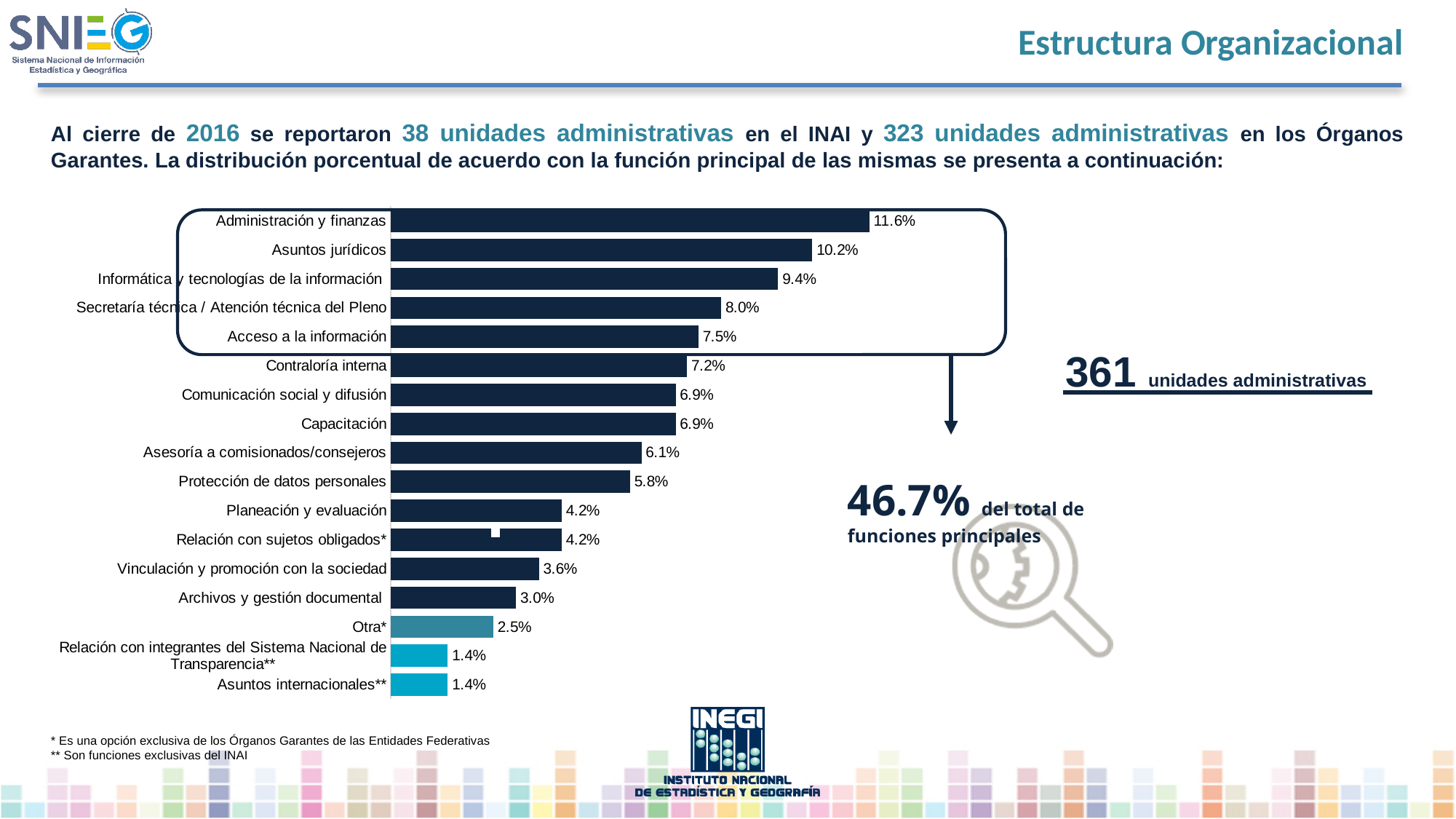
What is the difference between Secretaría técnica / Atención técnica del Pleno and Acceso a la información? 0.5% What is the combined percentage of the five categories enclosed in the rounded box at the top of the chart? 46.7% What percentage is shown for Administración y finanzas? 11.6% Which category has the highest percentage in the chart? Administración y finanzas Which is larger, Vinculación y promoción con la sociedad or Otra*? Vinculación y promoción con la sociedad What is the smallest percentage value shown in the chart? 1.4% What kind of chart is shown on the slide? Bar chart What is the value for Protección de datos personales? 5.8% Which is larger, the value for Contraloría interna or the value for Asesoría a comisionados/consejeros? Contraloría interna What is the difference between the values for Administración y finanzas and Asuntos jurídicos? 1.4% How many categories are plotted in the chart? 17 What percentage is shown for Archivos y gestión documental? 3.0%